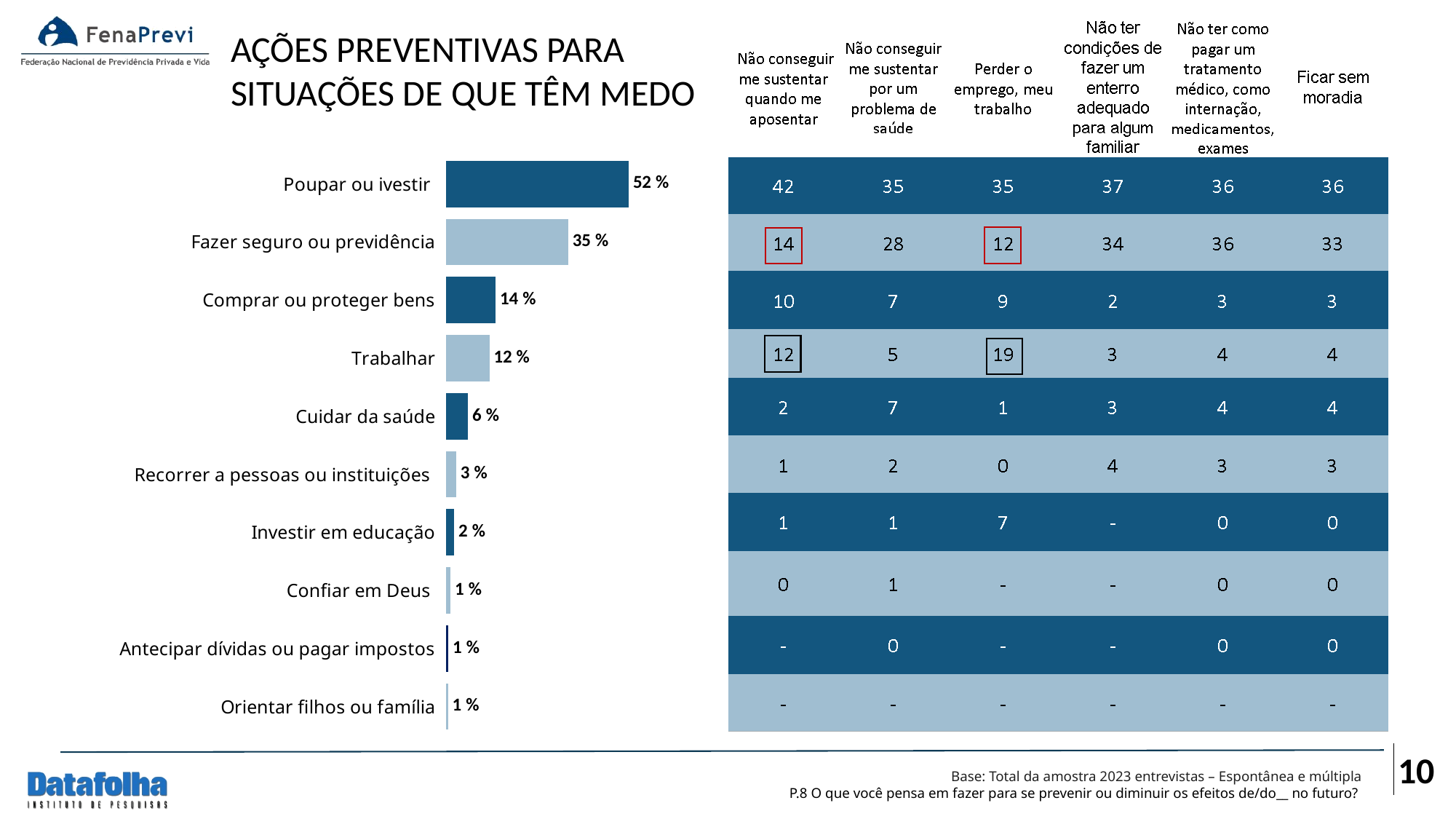
What is the value for "Cuidar da saúde" in the bar chart? 6 % Which is larger in the bar chart: "Comprar ou proteger bens" or "Trabalhar"? Comprar ou proteger bens What is the difference between the values for "Trabalhar" and "Cuidar da saúde"? 6 % What is the value for "Fazer seguro ou previdência" in the bar chart? 35 % What is the value for "Poupar ou ivestir" in the bar chart? 52 % What is the value for "Investir em educação" in the bar chart? 2 % Which category has the highest value in the bar chart? Poupar ou ivestir What is the value for "Comprar ou proteger bens" in the bar chart? 14 % What is the difference between the values for "Poupar ou ivestir" and "Fazer seguro ou previdência"? 17 % How many categories does the bar chart show? 10 What kind of chart is shown on the slide? Bar chart What is the title of the bar chart on the slide? AÇÕES PREVENTIVAS PARA SITUAÇÕES DE QUE TÊM MEDO